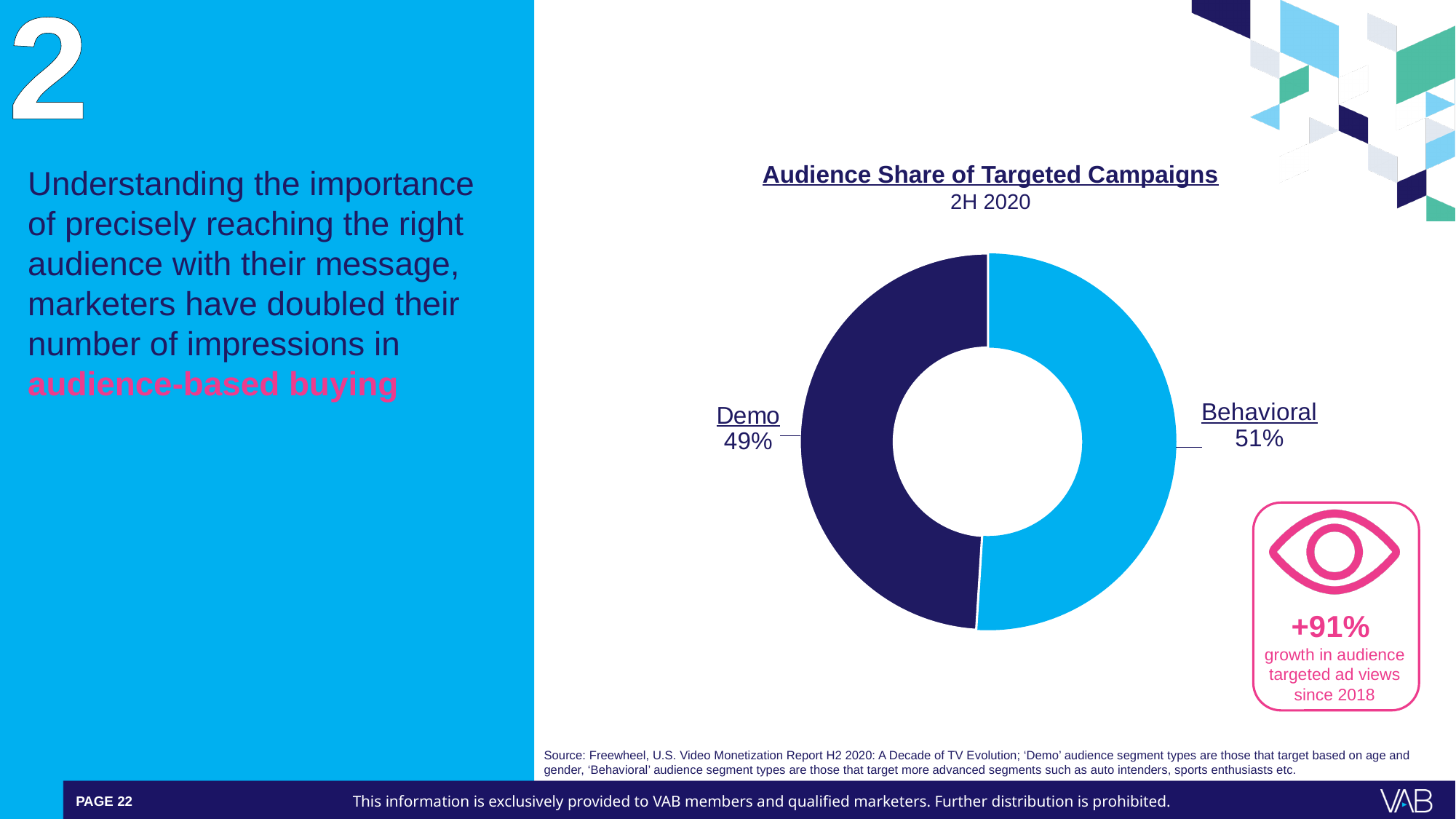
What kind of chart is used to show the Audience Share of Targeted Campaigns? Pie chart (donut) What share does the Behavioral slice represent in the Audience Share of Targeted Campaigns chart? 51% Is the Demo share greater or less than 50%? less What share does the Demo slice represent in the Audience Share of Targeted Campaigns chart? 49% Which segment has the smaller share in the Audience Share of Targeted Campaigns chart? Demo Is the Demo share larger or smaller than the Behavioral share? Smaller What time period does the Audience Share of Targeted Campaigns chart cover? 2H 2020 How many segments are shown in the Audience Share of Targeted Campaigns chart? 2 Is the Behavioral share greater or less than 50%? greater What is the title of the chart on the slide? Audience Share of Targeted Campaigns Which segment has the larger share in the Audience Share of Targeted Campaigns chart? Behavioral By how many percentage points does the Behavioral share exceed the Demo share? 2 percentage points